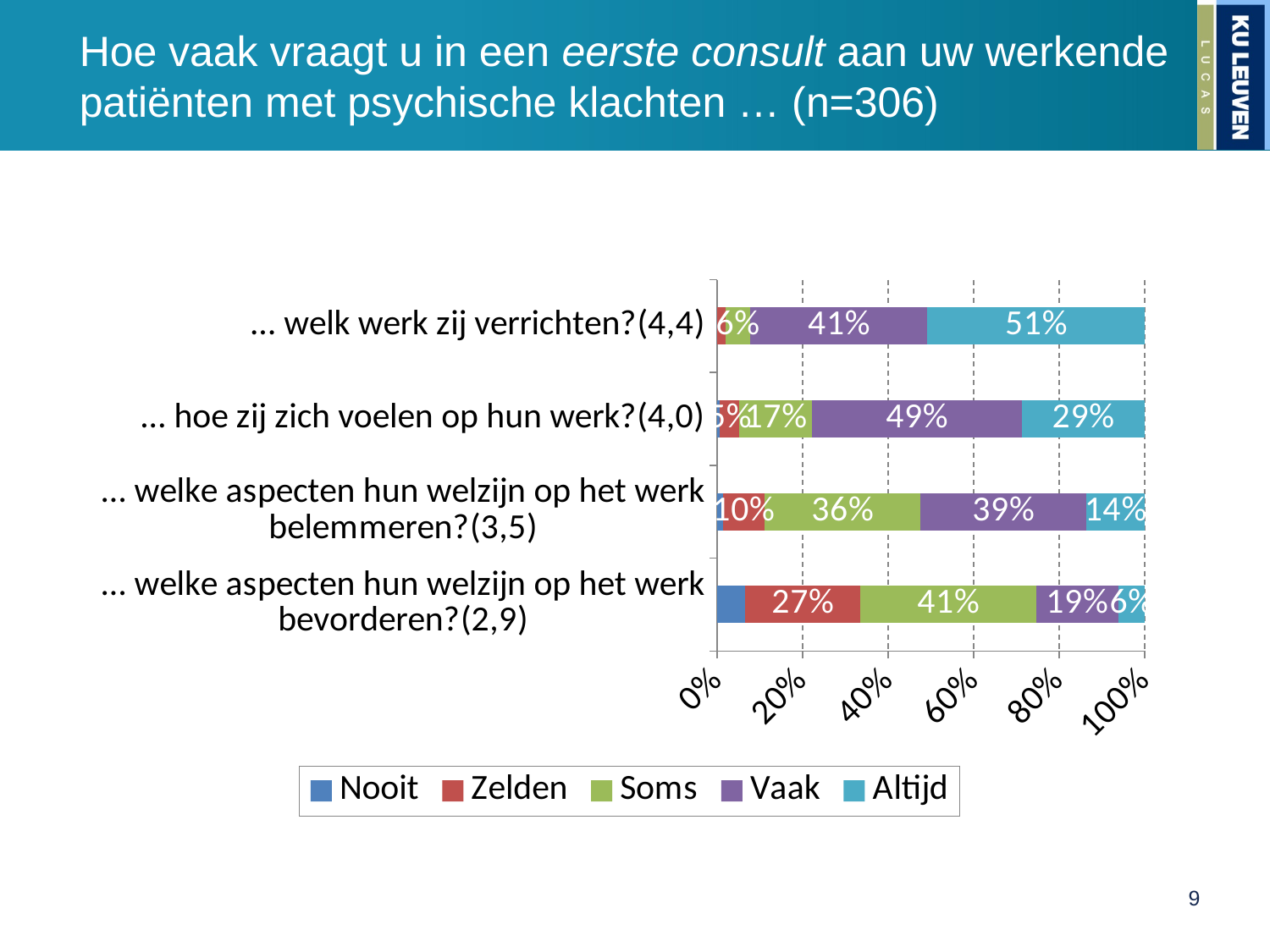
What is the 'Soms' value for '... welke aspecten hun welzijn op het werk belemmeren?(3,5)'? 36% What is the 'Altijd' value for '... welk werk zij verrichten?(4,4)'? 51% How many categories (questions) are plotted on the chart? 4 What is the difference between the 'Vaak' values for '... welk werk zij verrichten?(4,4)' and '... welke aspecten hun welzijn op het werk bevorderen?(2,9)'? 22% Which category has the highest 'Altijd' value? ... welk werk zij verrichten?(4,4) What kind of chart is shown on the slide? stacked bar chart Which series is shown in green in the legend? Soms Which is larger: the 'Soms' value for '... welke aspecten hun welzijn op het werk bevorderen?(2,9)' or the 'Soms' value for '... hoe zij zich voelen op hun werk?(4,0)'? ... welke aspecten hun welzijn op het werk bevorderen?(2,9) What is the 'Zelden' value for '... welke aspecten hun welzijn op het werk bevorderen?(2,9)'? 27% How many series does the legend list? 5 What is the 'Vaak' value for '... hoe zij zich voelen op hun werk?(4,0)'? 49% Which category has the lowest 'Altijd' value? ... welke aspecten hun welzijn op het werk bevorderen?(2,9)